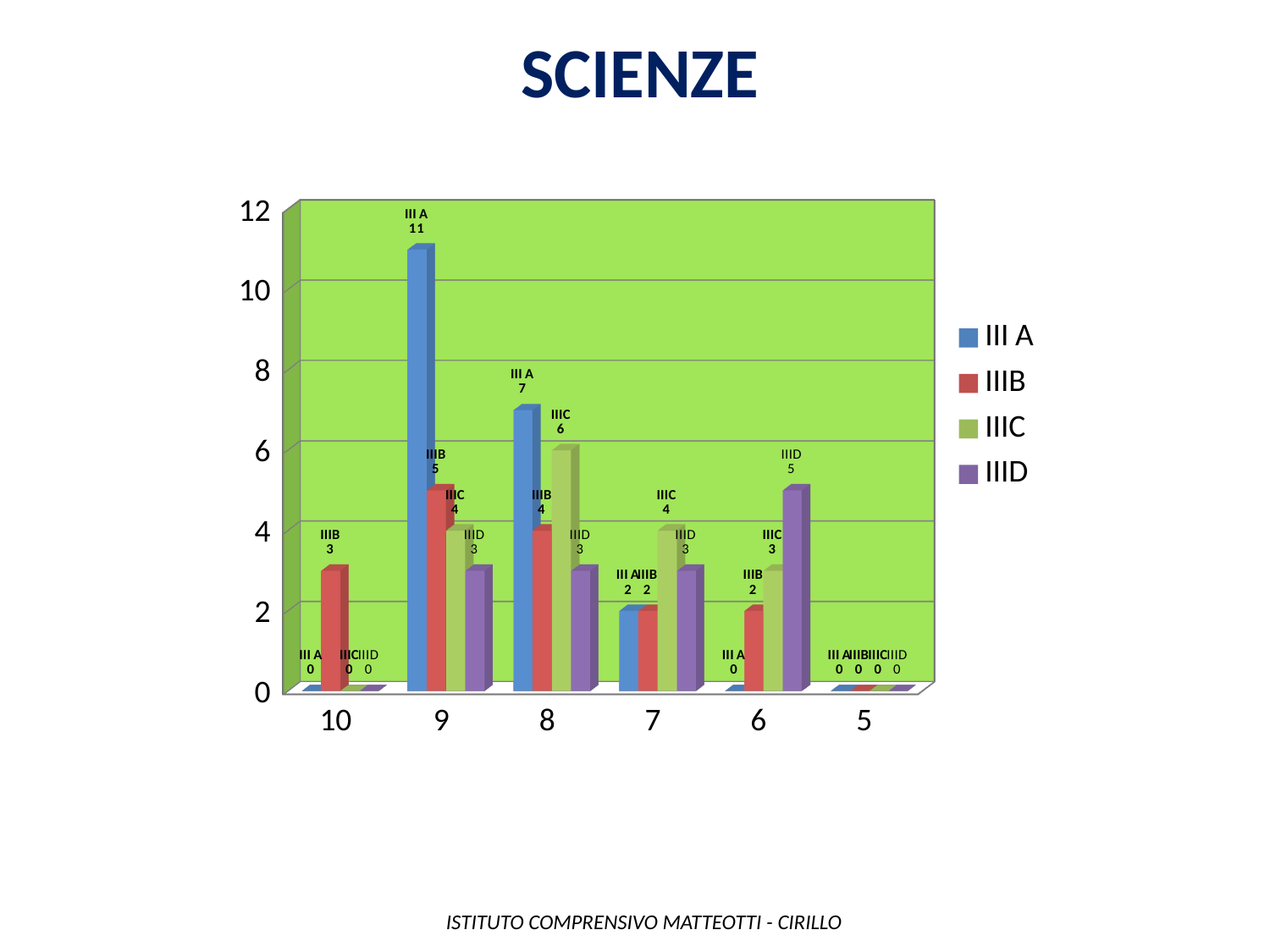
What is the title of the chart? SCIENZE What is the value for IIIC at category 8? 6 Which series has the lowest value at category 9? IIID How many series does the legend list? 4 What is the value for III A at category 9? 11 What is the value for IIIB at category 10? 3 Which category has the highest value for III A? 9 What kind of chart is shown on the slide? bar chart Which is larger at category 8: III A or IIIC? III A What is the difference between III A and IIIB at category 9? 6 What is the value for IIID at category 6? 5 How many categories are shown on the x axis? 6